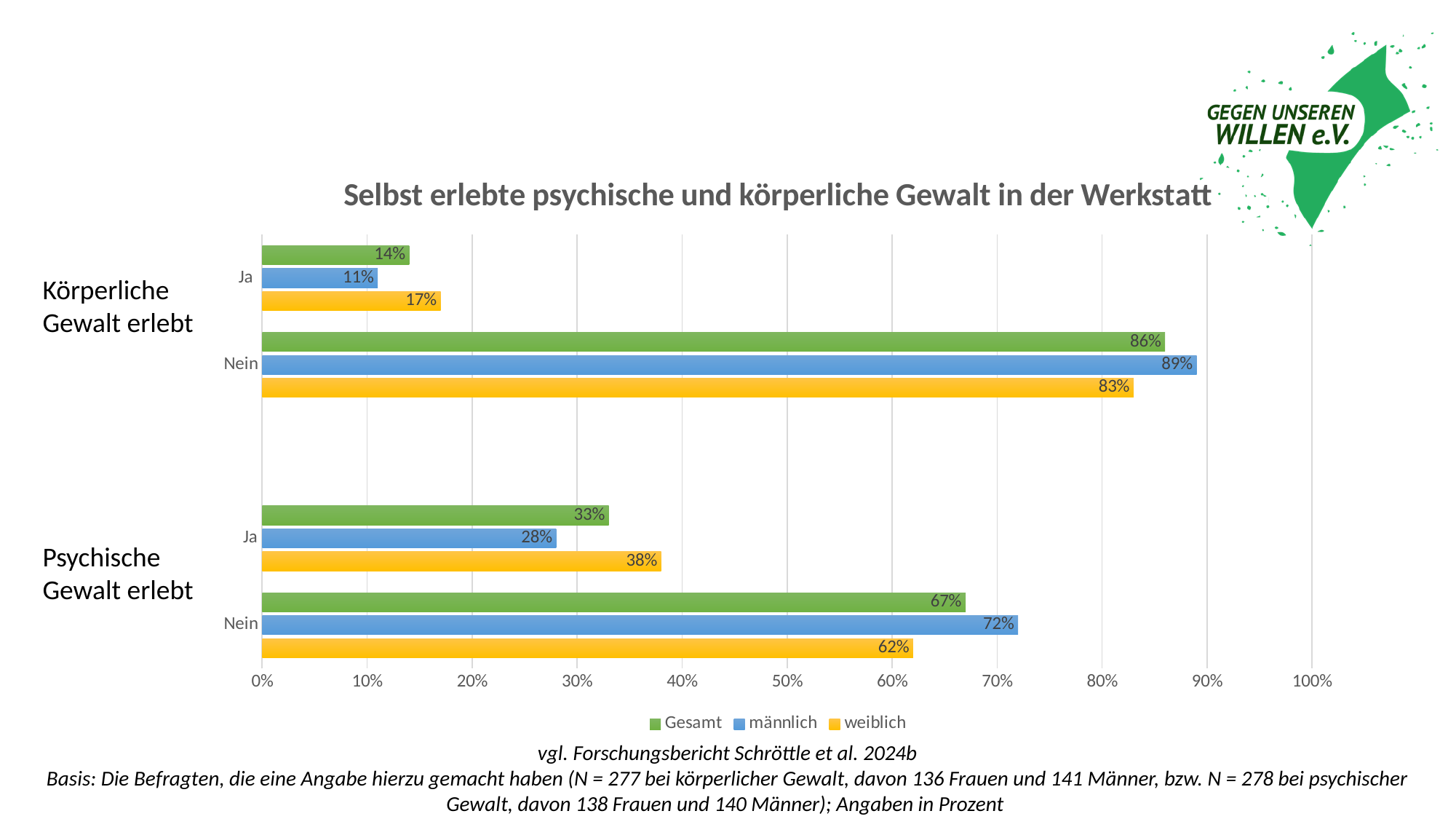
Which colour represents the 'weiblich' series? Yellow What is the value for 'weiblich' in the 'Ja' category under 'Körperliche Gewalt erlebt'? 17% Which series has the highest value for 'Nein' under 'Körperliche Gewalt erlebt'? männlich What kind of chart is shown on the slide? Bar chart Is the 'weiblich' value for 'Nein' under 'Psychische Gewalt erlebt' greater or less than 70%? less How many series does the legend list? 3 Which is larger: the 'Gesamt' value for 'Nein' under 'Körperliche Gewalt erlebt' or the 'Gesamt' value for 'Nein' under 'Psychische Gewalt erlebt'? Körperliche Gewalt erlebt (86%) Which series has the lowest value for 'Ja' under 'Psychische Gewalt erlebt'? männlich What is the title of the chart? Selbst erlebte psychische und körperliche Gewalt in der Werkstatt What is the value for 'männlich' in the 'Nein' category under 'Psychische Gewalt erlebt'? 72% What is the 'Gesamt' value for 'Ja' under 'Psychische Gewalt erlebt'? 33% What is the difference between the 'weiblich' and 'männlich' values for 'Ja' under 'Psychische Gewalt erlebt'? 10%